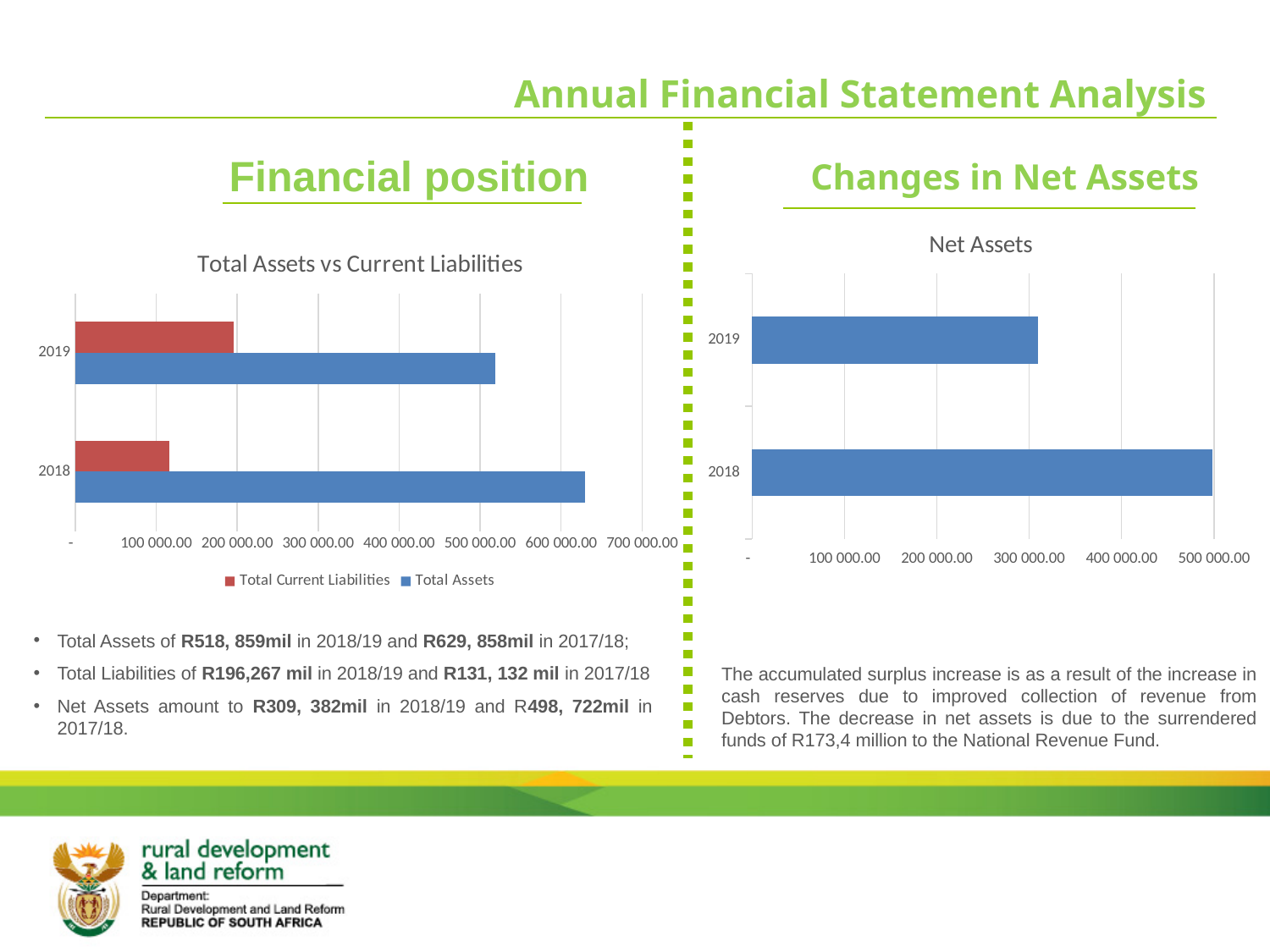
In the 'Total Assets vs Current Liabilities' chart, is the Total Assets value for 2019 greater or less than 500 000.00? greater What are the two legend entries in the 'Total Assets vs Current Liabilities' chart? Total Current Liabilities and Total Assets What kind of chart is the 'Net Assets' chart? bar chart In the 'Net Assets' chart, is the value for 2018 greater or less than 400 000.00? greater How many series does the legend of the 'Total Assets vs Current Liabilities' chart list? 2 In the 'Total Assets vs Current Liabilities' chart, is the Total Current Liabilities value for 2018 greater or less than 100 000.00? greater What kind of chart is the 'Total Assets vs Current Liabilities' chart? bar chart In the 'Total Assets vs Current Liabilities' chart, which year has the larger Total Assets bar, 2018 or 2019? 2018 In the 'Net Assets' chart, which year has the highest value? 2018 How many years are shown on the 'Total Assets vs Current Liabilities' chart? 2 In the 'Net Assets' chart, do net assets rise or fall from 2018 to 2019? fall